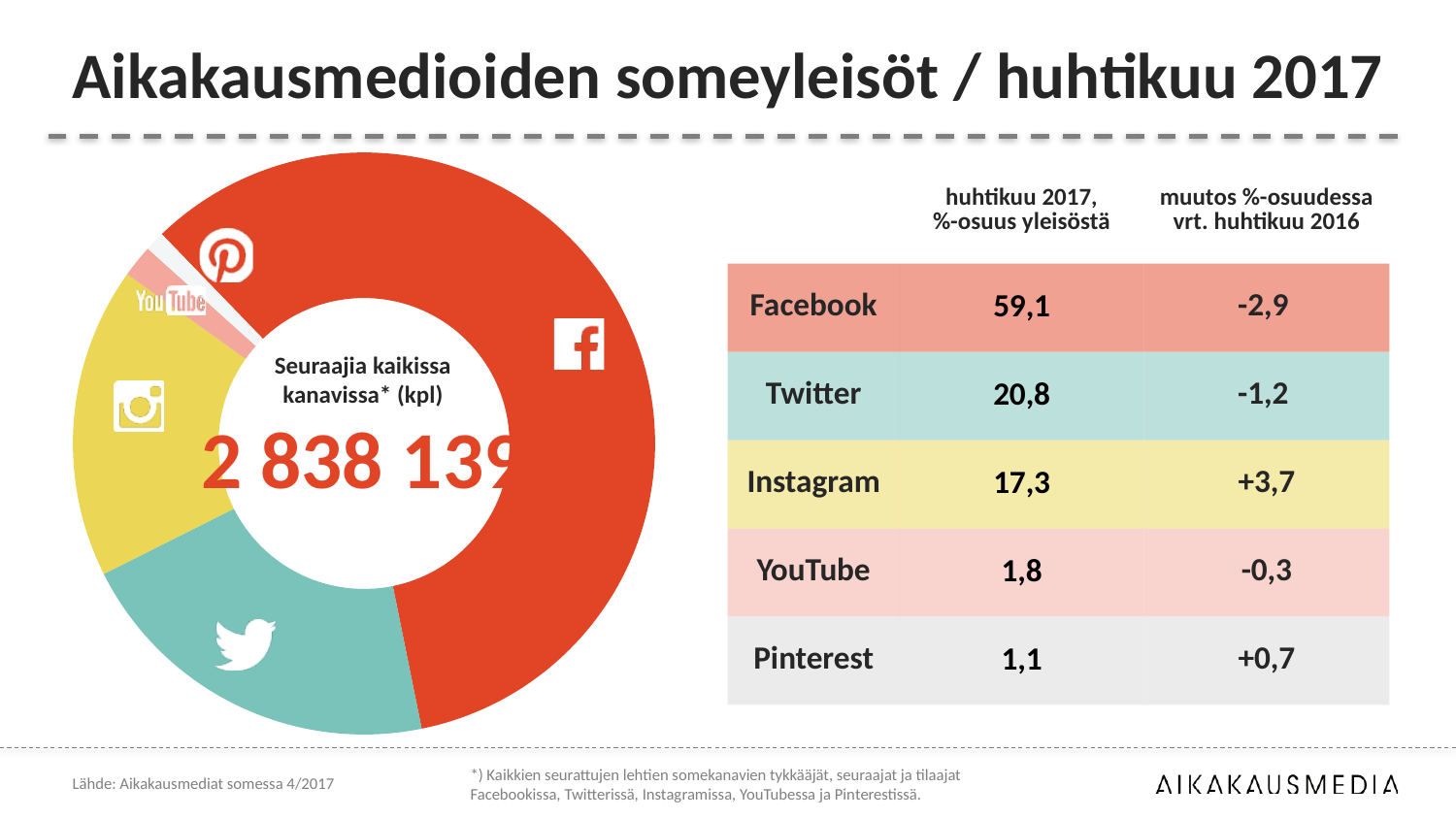
What is the change in Instagram's percentage share compared with April 2016? +3,7 What is the difference in percentage share between Facebook and Twitter in April 2017? 38,3 What is Facebook's percentage share of the audience in April 2017? 59,1 What is the total number of followers across all channels shown in the centre of the donut chart? 2 838 139 What is YouTube's percentage share of the audience in April 2017? 1,8 What kind of chart is shown on the left of the slide? Pie (donut) chart What is Twitter's percentage share of the audience in April 2017? 20,8 Which channel has a larger share of the audience, Twitter or Instagram? Twitter Which channel has the smallest share of the audience in the donut chart? Pinterest How many social media channels are shown as slices in the donut chart? 5 Which channel has the largest share of the audience in the donut chart? Facebook